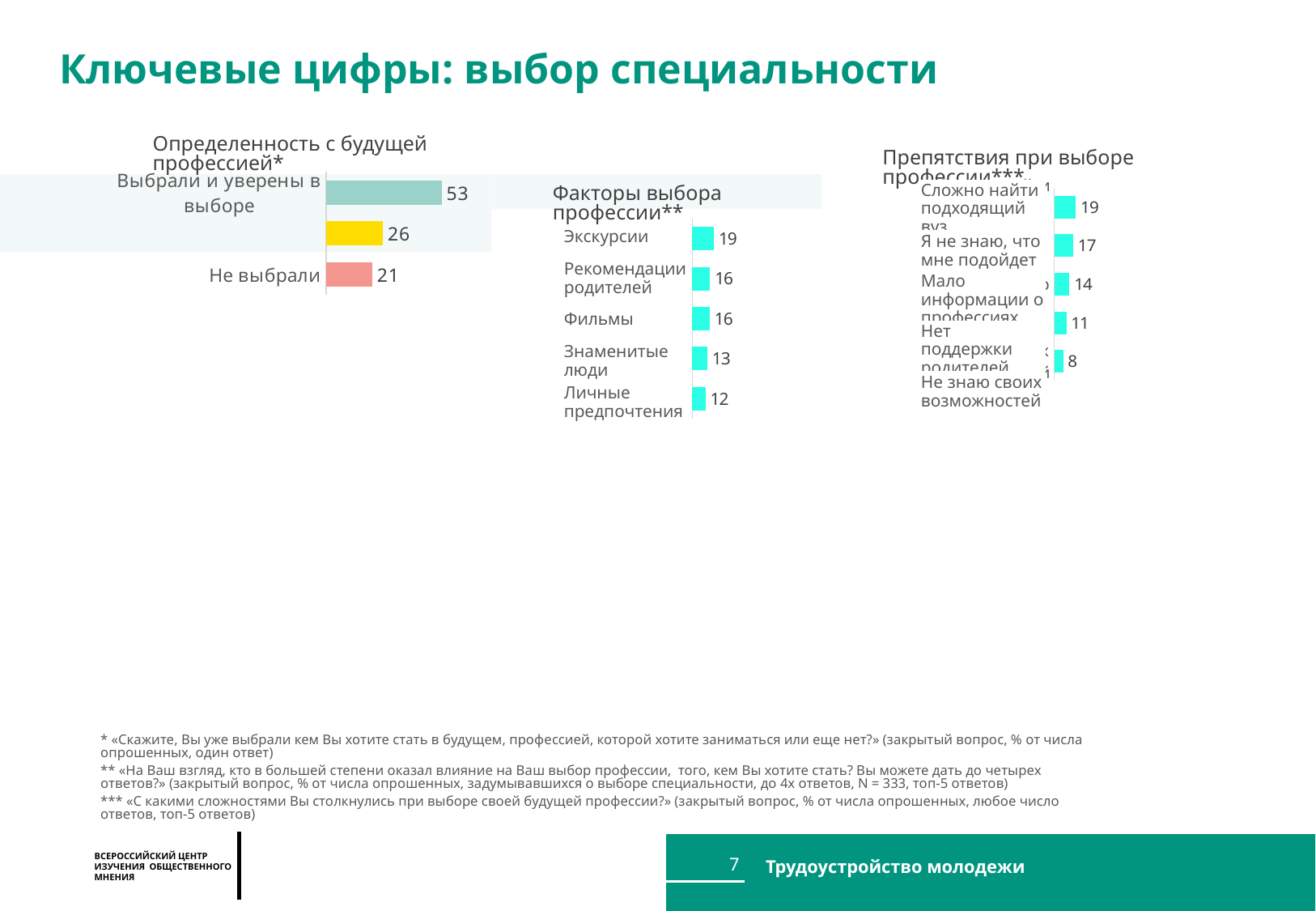
In the chart 'Факторы выбора профессии', what is the value for 'Знаменитые люди'? 13 In the chart 'Препятствия при выборе профессии', what is the value for 'Я не знаю, что мне подойдет'? 17 In the chart 'Определенность с будущей профессией', which category has the highest value? Выбрали и уверены в выборе In the chart 'Препятствия при выборе профессии', what is the lowest value shown? 8 In the chart 'Факторы выбора профессии', what is the value for 'Экскурсии'? 19 In the chart 'Определенность с будущей профессией', what is the value for 'Выбрали и уверены в выборе'? 53 In the chart 'Факторы выбора профессии', how many categories are shown? 5 What type of chart is 'Факторы выбора профессии'? Bar chart In the chart 'Факторы выбора профессии', which category has the lowest value? Личные предпочтения In the chart 'Факторы выбора профессии', which is larger: 'Экскурсии' or 'Фильмы'? Экскурсии In the chart 'Определенность с будущей профессией', what is the value for 'Не выбрали'? 21 In the chart 'Определенность с будущей профессией', what is the difference between 'Выбрали и уверены в выборе' and 'Не выбрали'? 32